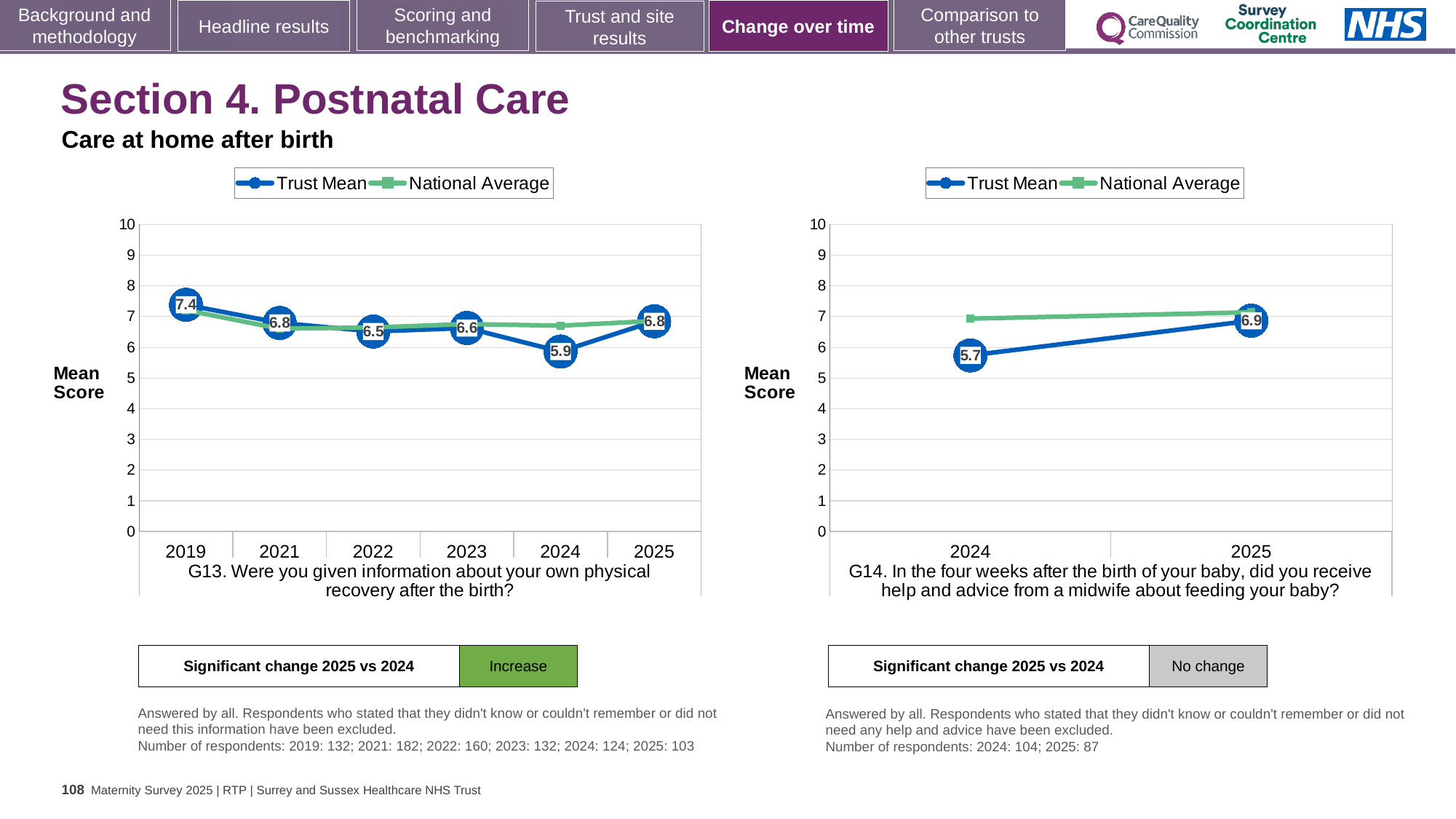
In the left chart (G13), what is the Trust Mean for 2024? 5.9 In the left chart (G13), which year has the highest Trust Mean? 2019 How many years are shown on the x axis of the left chart (G13)? 6 In the right chart (G14), is the National Average for 2024 greater or less than 6? greater In the right chart (G14), what is the Trust Mean for 2025? 6.9 In the left chart (G13), what is the difference between the Trust Mean for 2019 and 2024? 1.5 What kind of chart is the right chart (G14)? Line chart In the right chart (G14), what is the difference between the Trust Mean for 2025 and 2024? 1.2 In the left chart (G13), is the Trust Mean higher in 2022 or 2023? 2023 In the left chart (G13), which year has the lowest Trust Mean? 2024 How many series does the legend of the right chart (G14) list? 2 In the left chart (G13), what is the Trust Mean for 2019? 7.4